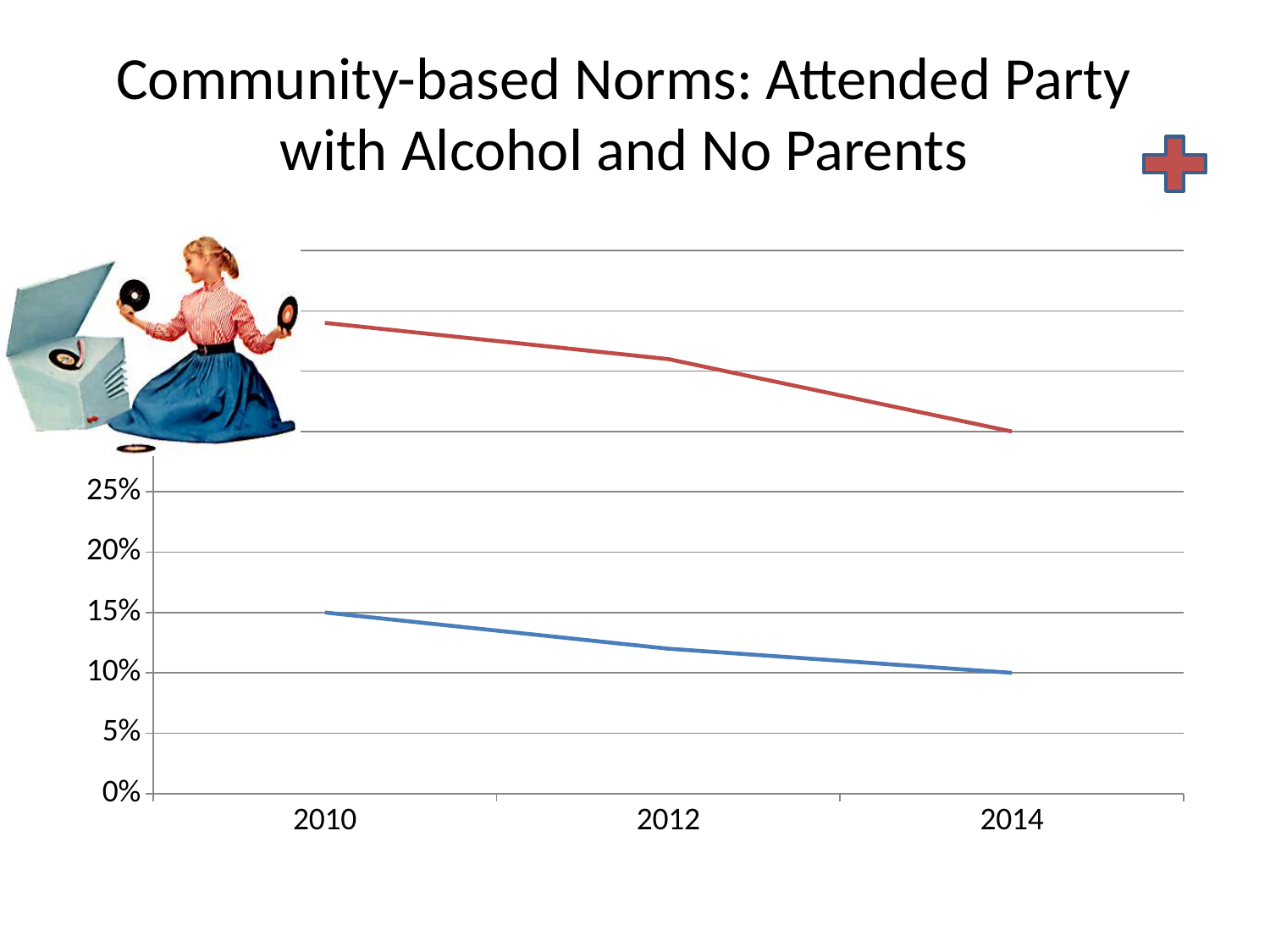
What is the title of the slide containing the chart? Community-based Norms: Attended Party with Alcohol and No Parents Does the blue line rise or fall from 2010 to 2014? fall By how much did the blue line fall from 2010 to 2014? 5% How many lines are plotted on the chart? 2 What is the value of the blue line in 2010? 15% Is the value of the blue line in 2012 greater or less than 10%? greater What kind of chart is shown on the slide? line chart Is the value of the red line in 2014 greater or less than 25%? greater What is the value of the blue line in 2014? 10% How many years are plotted along the x axis? 3 Does the red line rise or fall from 2010 to 2014? fall Which line has the higher value in 2012, the red line or the blue line? red line